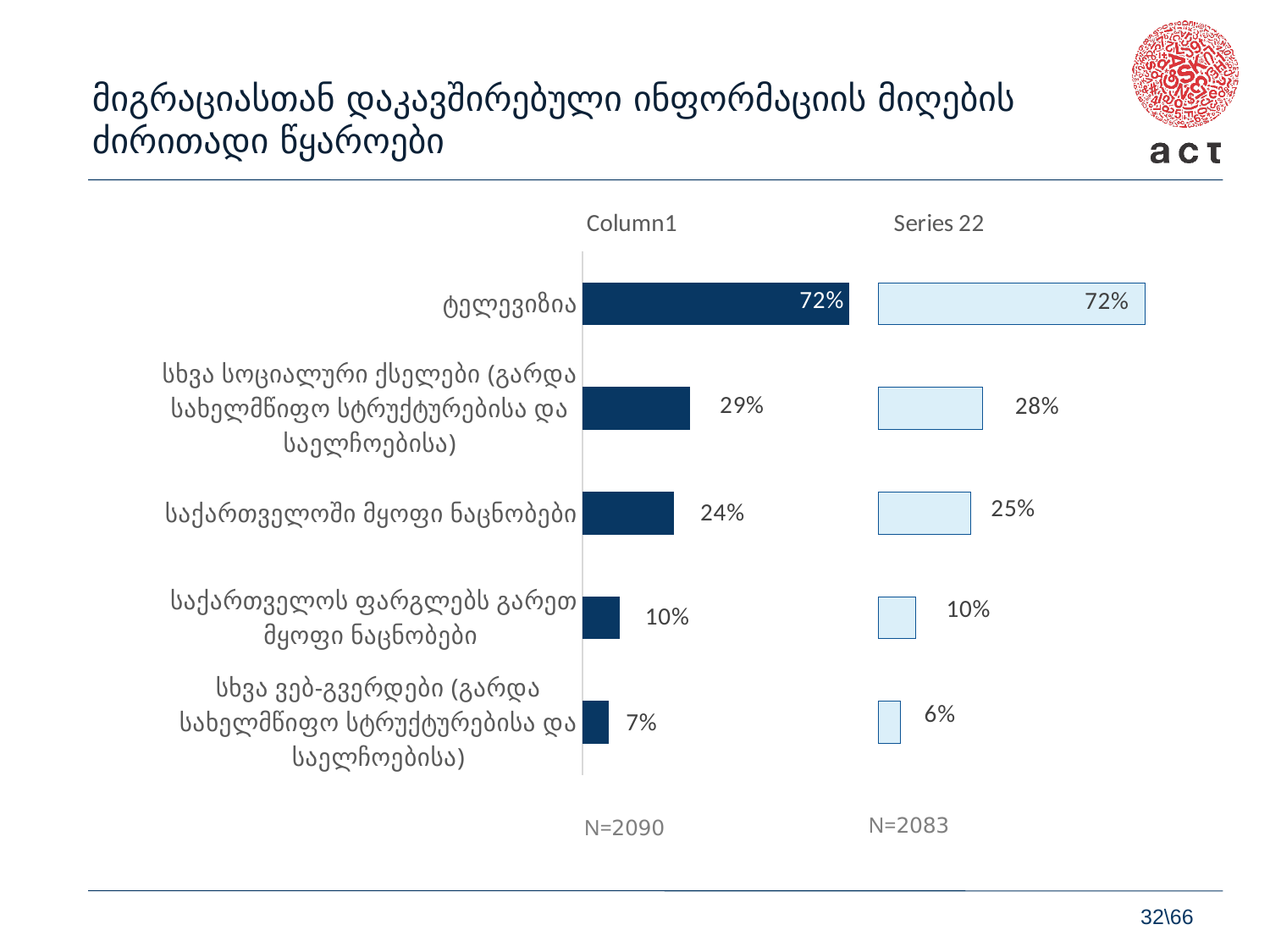
What sample size (N) is shown under the Column1 chart? N=2090 In the Column1 chart, what is the difference between the values for ტელევიზია and სხვა სოციალური ქსელები (გარდა სახელმწიფო სტრუქტურებისა და საელჩოებისა)? 43% In the Column1 chart, what is the value for სხვა ვებ-გვერდები (გარდა სახელმწიფო სტრუქტურებისა და საელჩოებისა)? 7% In the Series 22 chart, what is the value for სხვა სოციალური ქსელები (გარდა სახელმწიფო სტრუქტურებისა და საელჩოებისა)? 28% In the Series 22 chart, what is the value for საქართველოში მყოფი ნაცნობები? 25% In the Series 22 chart, which category has the lowest value? სხვა ვებ-გვერდები (გარდა სახელმწიფო სტრუქტურებისა და საელჩოებისა) What type of chart is the Series 22 chart? bar chart In the Column1 chart, which category has the highest value? ტელევიზია Which chart has the larger value for საქართველოში მყოფი ნაცნობები, Column1 or Series 22? Series 22 In the Series 22 chart, what is the difference between the values for საქართველოში მყოფი ნაცნობები and საქართველოს ფარგლებს გარეთ მყოფი ნაცნობები? 15% How many categories are shown in the Column1 chart? 5 In the Column1 chart, what is the value for ტელევიზია? 72%